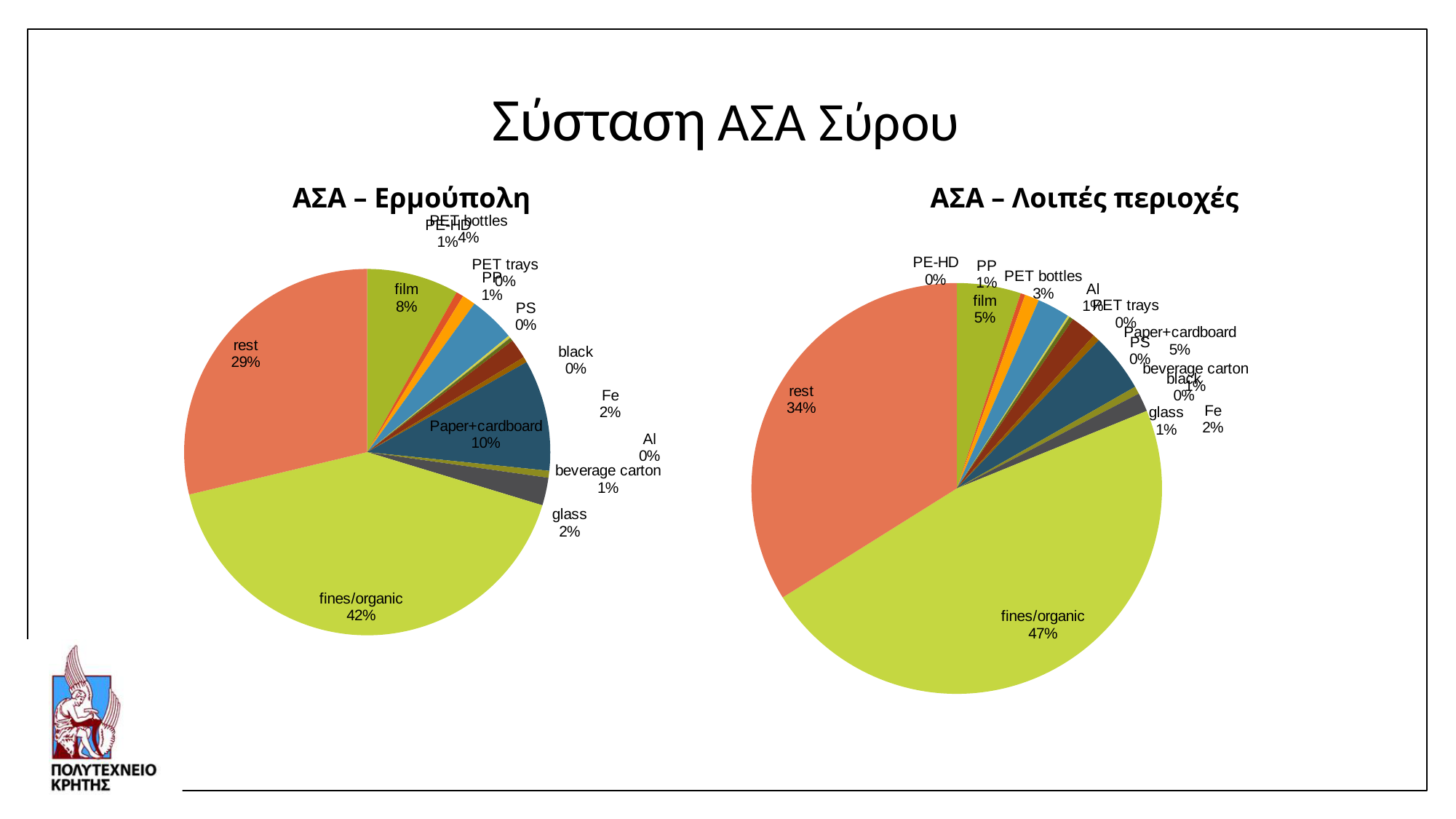
Which chart has the larger share for film, ΑΣΑ – Ερμούπολη or ΑΣΑ – Λοιπές περιοχές? ΑΣΑ – Ερμούπολη Which category has the largest slice in the ΑΣΑ – Ερμούπολη chart? fines/organic In the ΑΣΑ – Λοιπές περιοχές chart, what share does film have? 5% In the ΑΣΑ – Λοιπές περιοχές chart, what share does fines/organic have? 47% In the ΑΣΑ – Ερμούπολη chart, what share does fines/organic have? 42% Which category has the largest slice in the ΑΣΑ – Λοιπές περιοχές chart? fines/organic In the ΑΣΑ – Ερμούπολη chart, what share does Paper+cardboard have? 10% What is the title of the chart on the right side of the slide? ΑΣΑ – Λοιπές περιοχές What kind of chart is the ΑΣΑ – Ερμούπολη chart? pie chart In the ΑΣΑ – Ερμούπολη chart, what is the difference between the fines/organic share and the rest share? 13% In the ΑΣΑ – Ερμούπολη chart, what share does rest have? 29% In the ΑΣΑ – Λοιπές περιοχές chart, what share does rest have? 34%